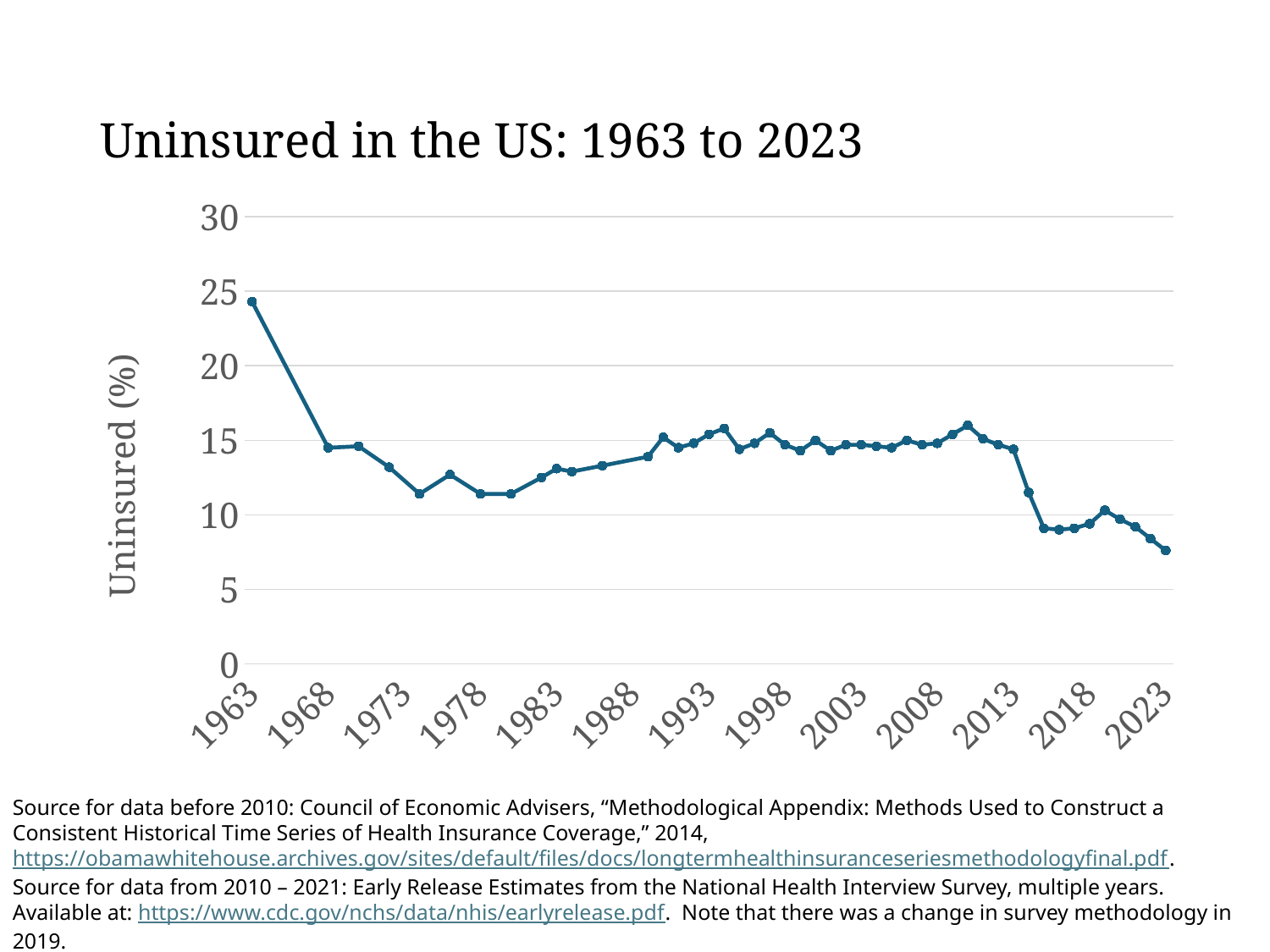
What is the label on the vertical axis of the chart? Uninsured (%) What is the title of the chart? Uninsured in the US: 1963 to 2023 What kind of chart is shown on the slide? line chart Is the uninsured percentage for 2023 greater or less than 10? less Which year has a higher uninsured percentage, 2008 or 2018? 2008 Overall, does the uninsured percentage rise or fall from 1963 to 2023? fall In which year shown on the x axis is the uninsured percentage lowest? 2023 In which year shown on the x axis is the uninsured percentage highest? 1963 Is the uninsured percentage for 1978 greater or less than 10? greater Is the uninsured percentage for 1963 greater or less than 20? greater